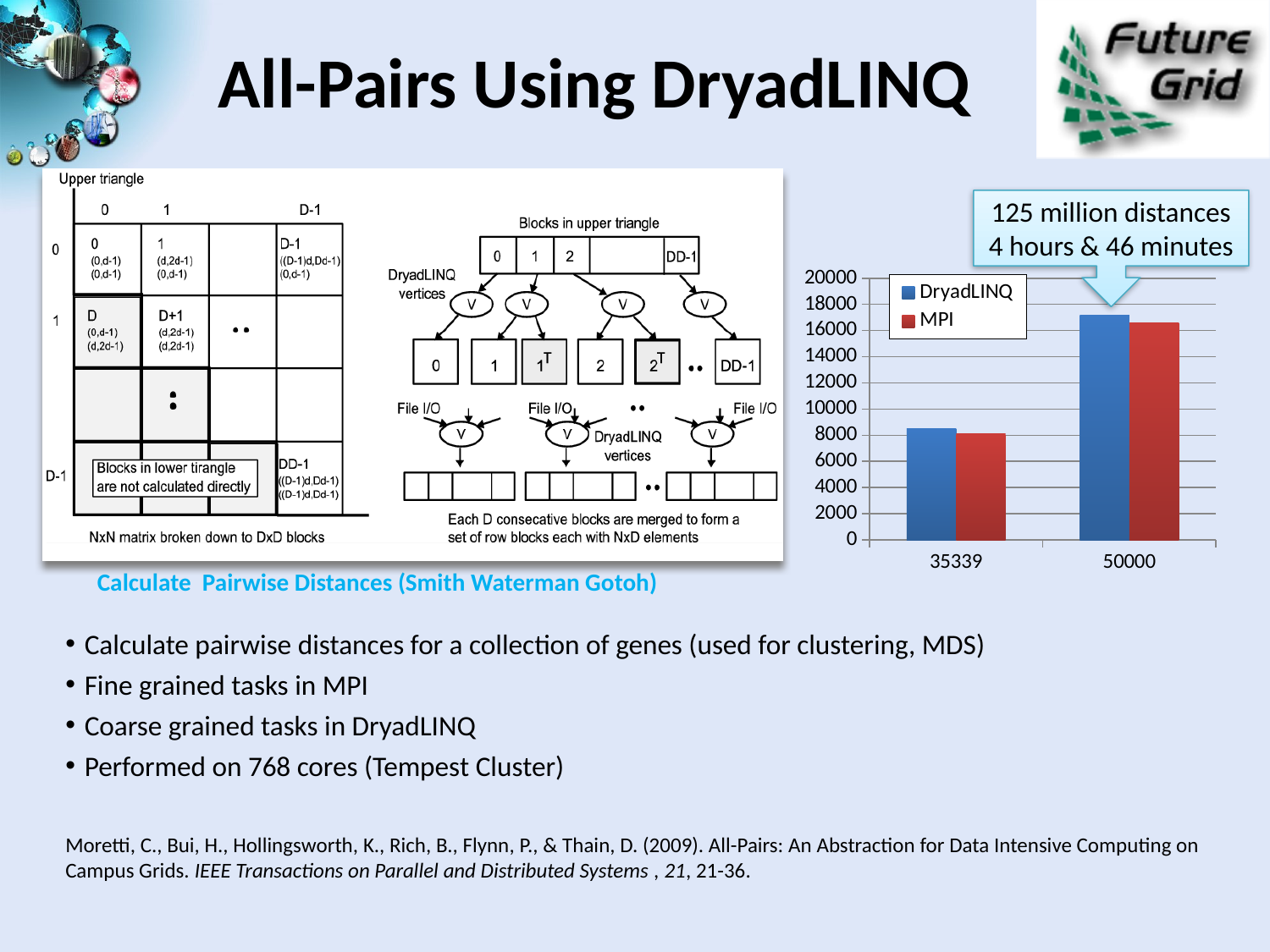
Which category on the x axis of the bar chart has the lowest bars? 35339 Is the MPI value for 35339 greater or less than 10000? less Which category on the x axis of the bar chart has the highest bars? 50000 Is the MPI value for 50000 greater or less than 14000? greater How many series does the legend of the bar chart list? 2 Which colour represents the MPI series in the bar chart? red Do the bar values rise or fall from 35339 to 50000 on the x axis? rise What kind of chart is shown on the right side of the slide? bar chart Is the DryadLINQ value for 35339 greater or less than 10000? less How many categories are shown on the x axis of the bar chart? 2 What are the two series named in the legend of the bar chart? DryadLINQ and MPI